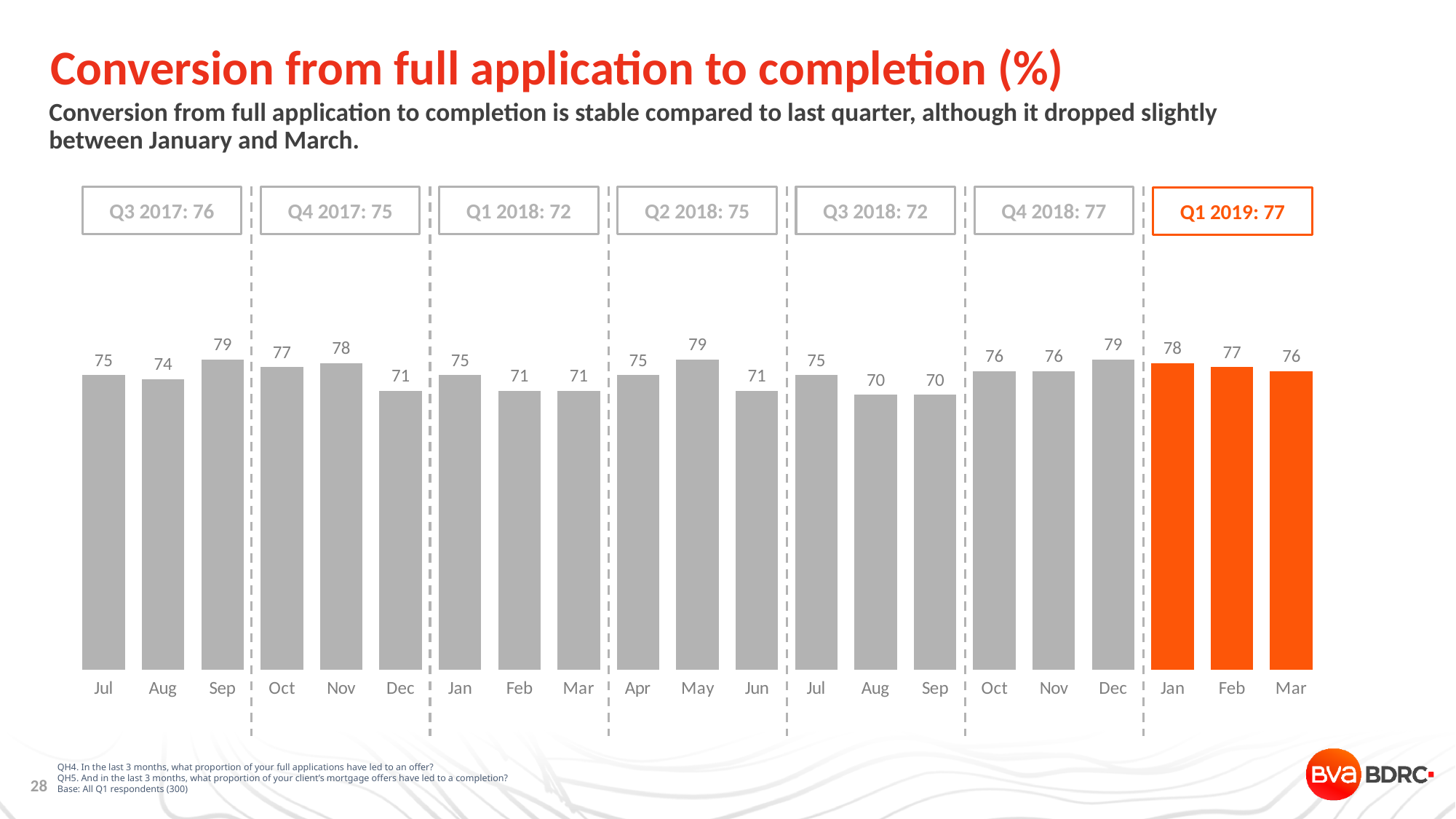
What is the highest monthly value shown on the chart? 79 What kind of chart is shown on the slide? Bar chart Which is larger, the May value in Q2 2018 or the Jun value in Q2 2018? May Do the values rise or fall from Jan to Mar in the Q1 2019 section? Fall What is the value for Dec in the Q4 2018 section of the chart? 79 What is the value for Jan in the Q1 2019 section of the chart? 78 What is the value for Aug in the Q3 2018 section of the chart? 70 What quarterly value is shown in the box labelled Q1 2019? 77 What is the value for Nov in the Q4 2017 section of the chart? 78 How many monthly bars are plotted on the chart? 21 What is the lowest monthly value shown on the chart? 70 What is the difference between the Jan and Mar values in the Q1 2019 section? 2